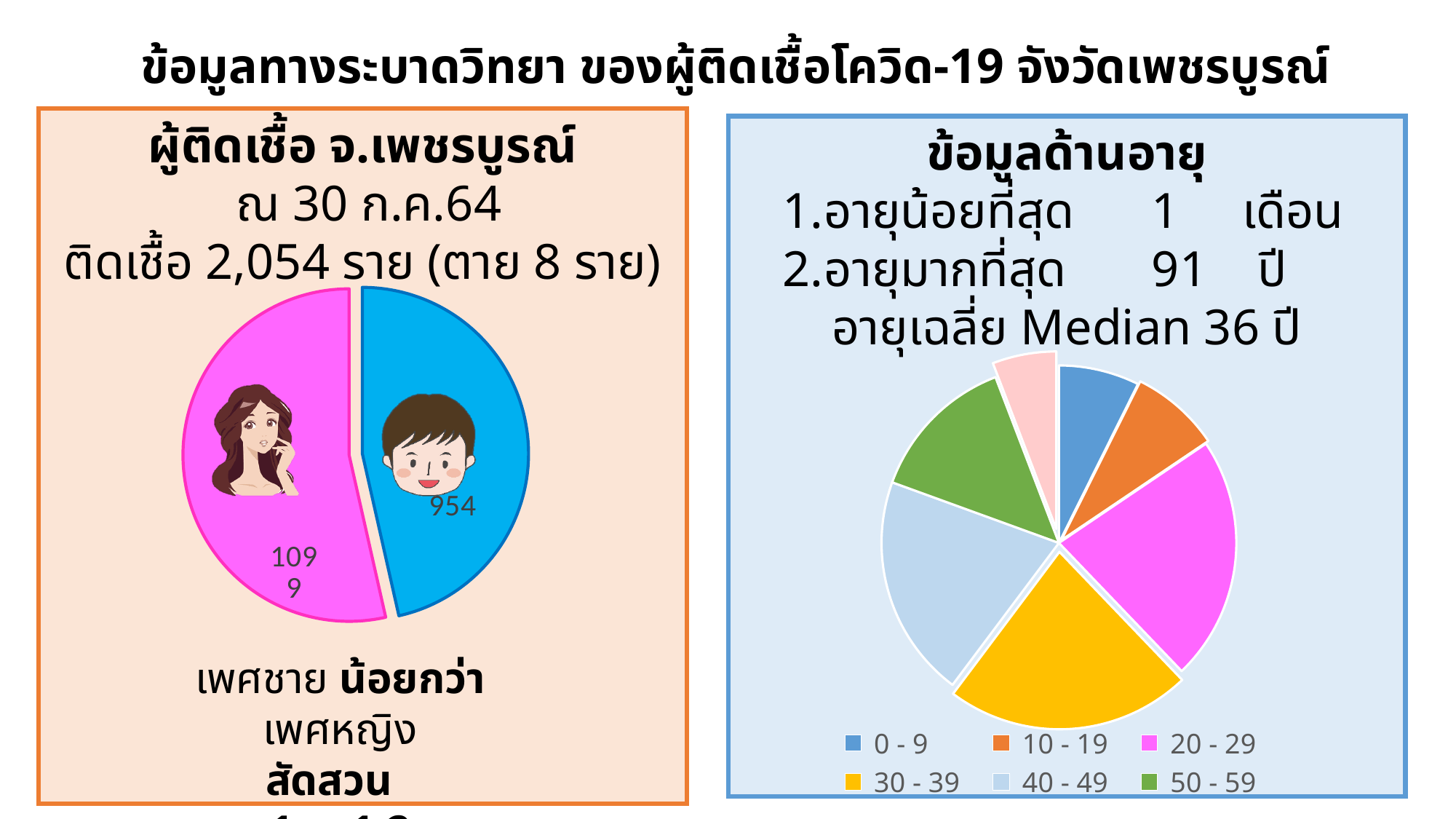
In the left pie chart, which slice is larger, the blue (male) slice or the pink (female) slice? pink (female) In the left pie chart, what is the value shown on the pink (female) slice? 1099 What kind of chart is shown in the left panel (ผู้ติดเชื้อ จ.เพชรบูรณ์)? pie chart In the left pie chart, what is the value shown on the blue (male) slice? 954 In the right pie chart, which slice is larger, 40 - 49 or 10 - 19? 40 - 49 In the left pie chart, what is the difference between the female value and the male value? 145 What is the title of the right panel containing the age pie chart? ข้อมูลด้านอายุ How many age groups are listed in the legend of the right pie chart? 6 How many slices does the left pie chart have? 2 In the right pie chart, what colour represents the 30 - 39 age group? yellow What kind of chart is shown in the right panel (ข้อมูลด้านอายุ)? pie chart In the right pie chart, which slice is larger, 20 - 29 or 0 - 9? 20 - 29